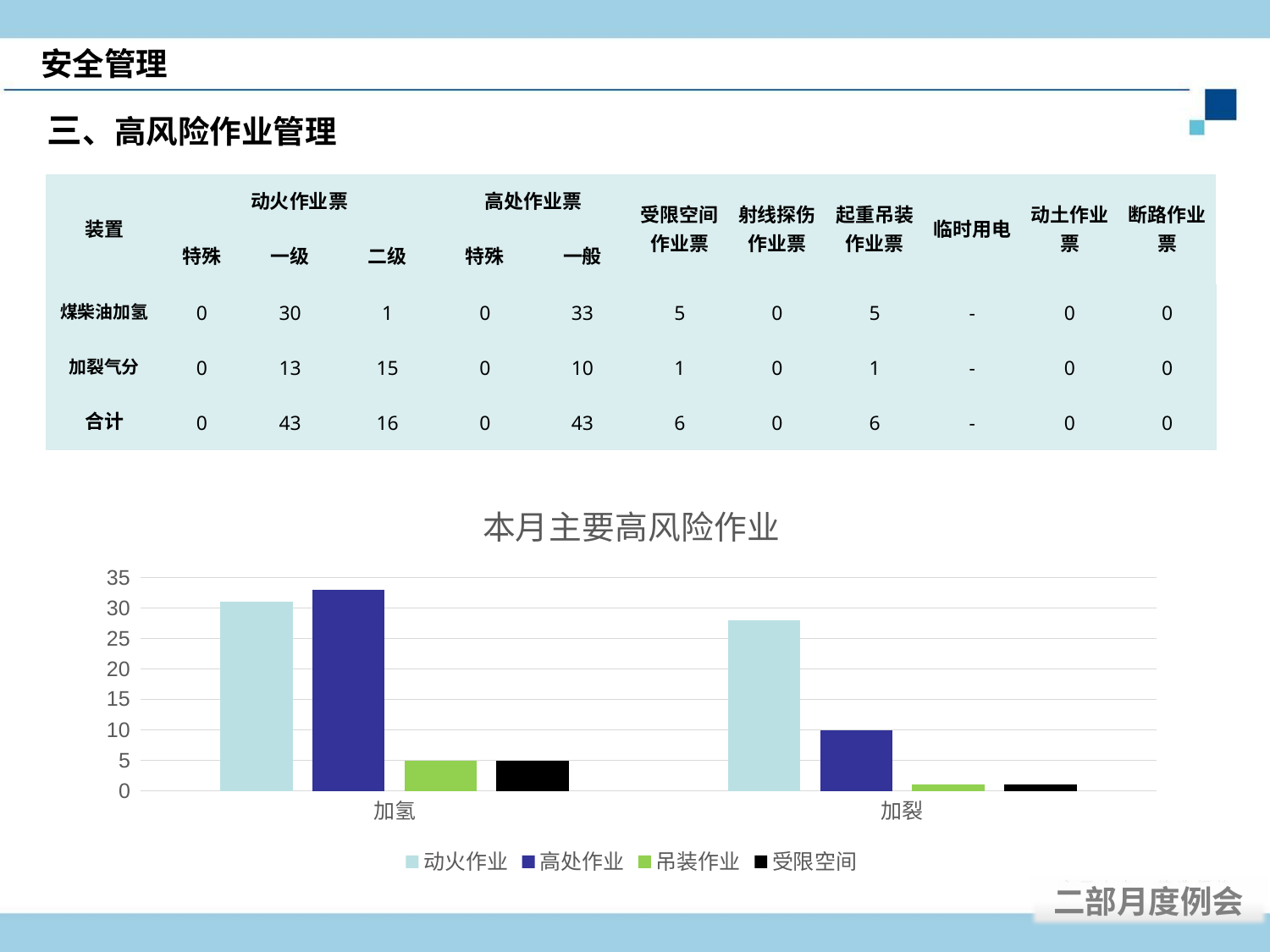
How many series does the chart legend list? 4 Is the value of 高处作业 for 加氢 greater or less than 30? greater Is the value of 动火作业 for 加氢 greater or less than 25? greater What is the value of 吊装作业 for 加氢? 5 Is the value of 高处作业 for 加裂 greater or less than 15? less Which colour represents 受限空间 in the chart legend? black What kind of chart is shown on the slide? bar chart What is the title of the chart? 本月主要高风险作业 Which series has the highest value for 加裂? 动火作业 What is the value of 高处作业 for 加裂? 10 How many categories are shown on the x axis of the chart? 2 Which category has the larger value for 高处作业, 加氢 or 加裂? 加氢